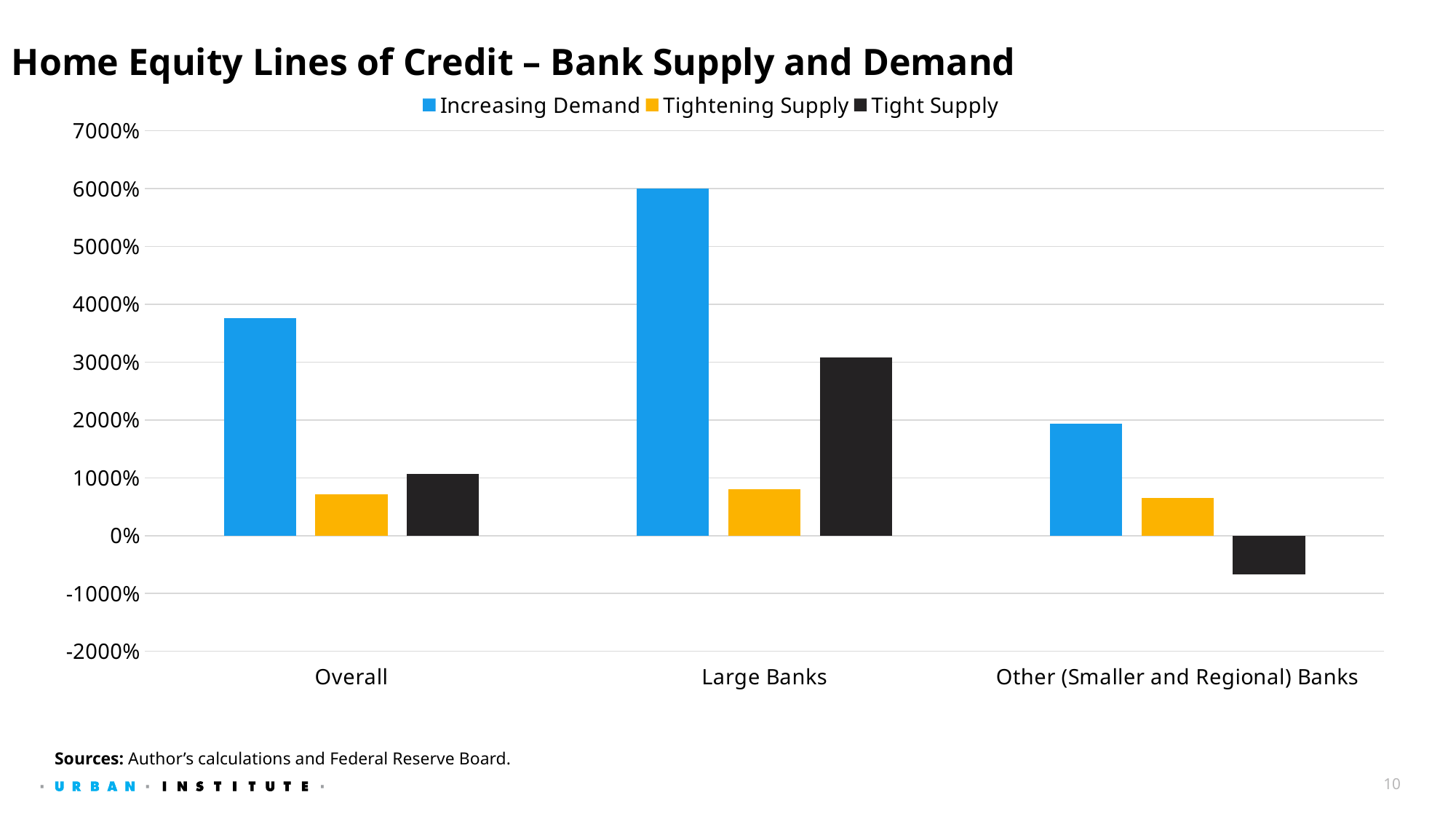
How many series does the legend list? 3 Which series is shown in blue? Increasing Demand Which category has the lowest Tight Supply value? Other (Smaller and Regional) Banks Is the Tight Supply value for Other (Smaller and Regional) Banks greater or less than 0%? less Which category has the highest Increasing Demand value? Large Banks What kind of chart is shown on the slide? bar chart Which is larger: the Increasing Demand value for Overall or for Other (Smaller and Regional) Banks? Overall How many categories are shown on the x axis? 3 Is the Tightening Supply value for Large Banks greater or less than 1000%? less Which is larger for Large Banks: Tight Supply or Tightening Supply? Tight Supply What is the title of the chart? Home Equity Lines of Credit – Bank Supply and Demand Is the Increasing Demand value for Overall greater or less than 3000%? greater